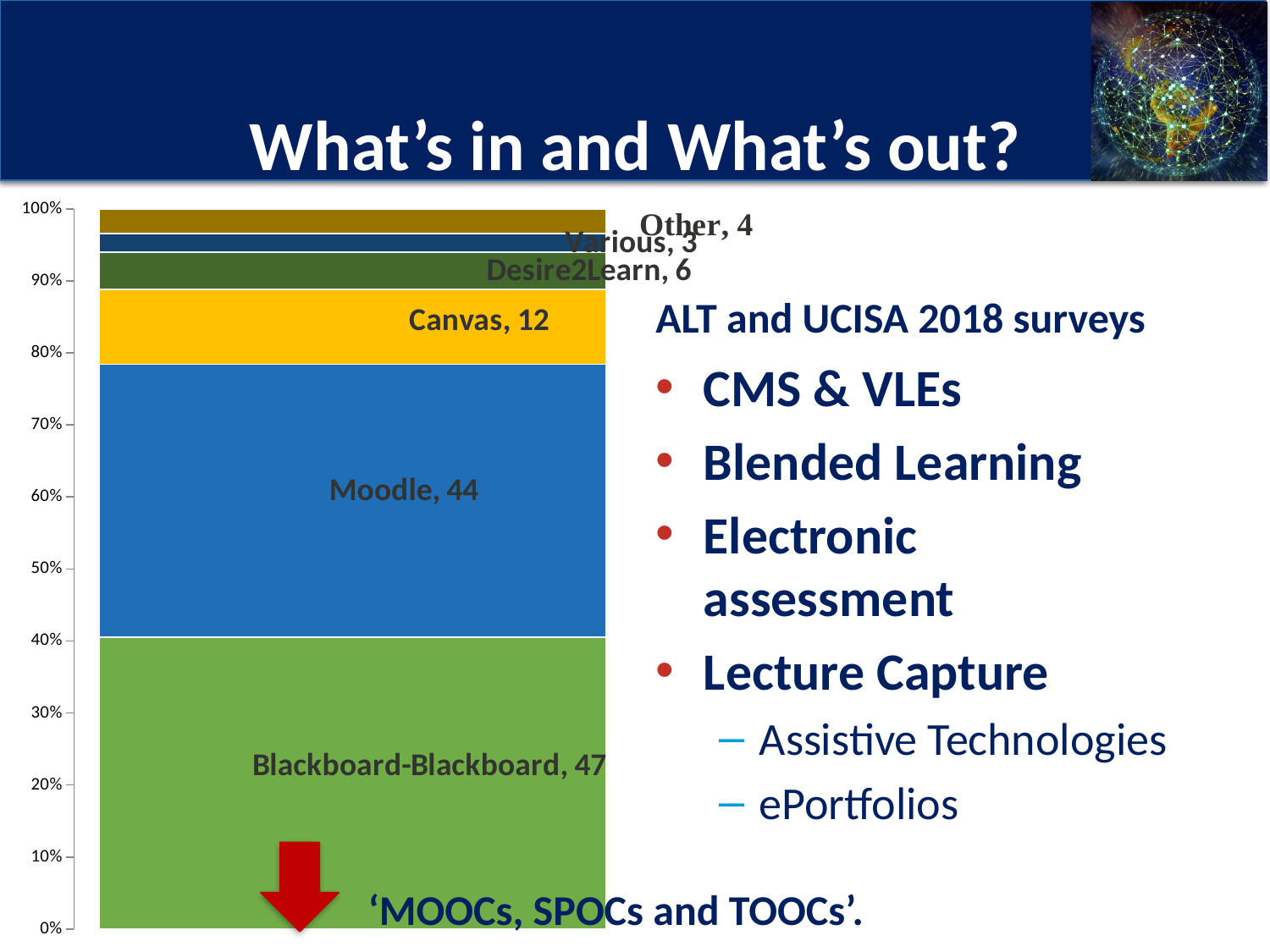
What kind of chart is shown on the slide? Stacked bar chart Which segment has the largest value? Blackboard-Blackboard What is the total of all the segment values in the stacked bar? 116 How many segments make up the stacked bar? 6 What value is shown for the Other segment? 4 Which segment has the smallest value? Various What is the difference between the Canvas value and the Desire2Learn value? 6 What value is shown for the Desire2Learn segment? 6 What value is shown for the Canvas segment? 12 Which is larger, the value for Canvas or the value for Other? Canvas What value is shown for the Moodle segment? 44 What is the difference between the Blackboard-Blackboard value and the Moodle value? 3